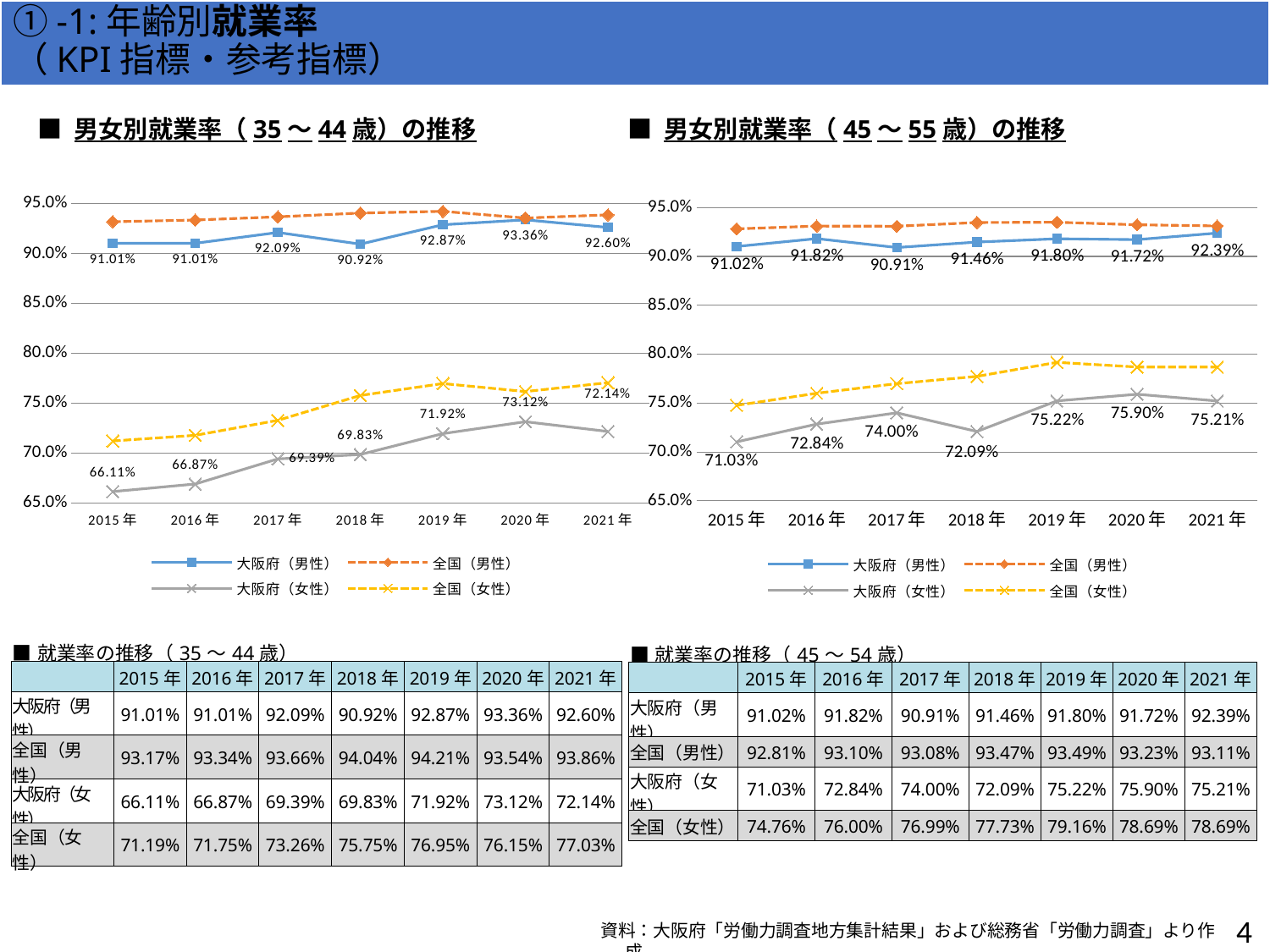
In the left chart (35～44歳), does the 全国（女性） line rise or fall from 2015年 to 2019年? Rise In the left chart (35～44歳), is the value for 全国（女性） in 2015年 greater or less than 75.0%? less In the right chart (45～55歳), which year has the larger 大阪府（女性） value, 2019年 or 2020年? 2020年 In the right chart (45～55歳), in which year is the 大阪府（女性） value lowest? 2015年 In the left chart (男女別就業率（35～44歳）の推移), what is the value for 大阪府（女性） in 2015年? 66.11% In the left chart (35～44歳), in which year is the 大阪府（男性） value highest? 2020年 In the left chart (35～44歳), by how much did the 大阪府（女性） value increase from 2015年 to 2021年? 6.03 percentage points What kind of chart is the left chart (男女別就業率（35～44歳）の推移)? Line chart How many years are shown on the x axis of the left chart (35～44歳)? 7 In the right chart (男女別就業率（45～55歳）の推移), what is the value for 大阪府（男性） in 2021年? 92.39% How many series does the legend of the right chart (45～55歳) list? 4 In the right chart (45～55歳), in which year is the 大阪府（男性） value lowest? 2017年